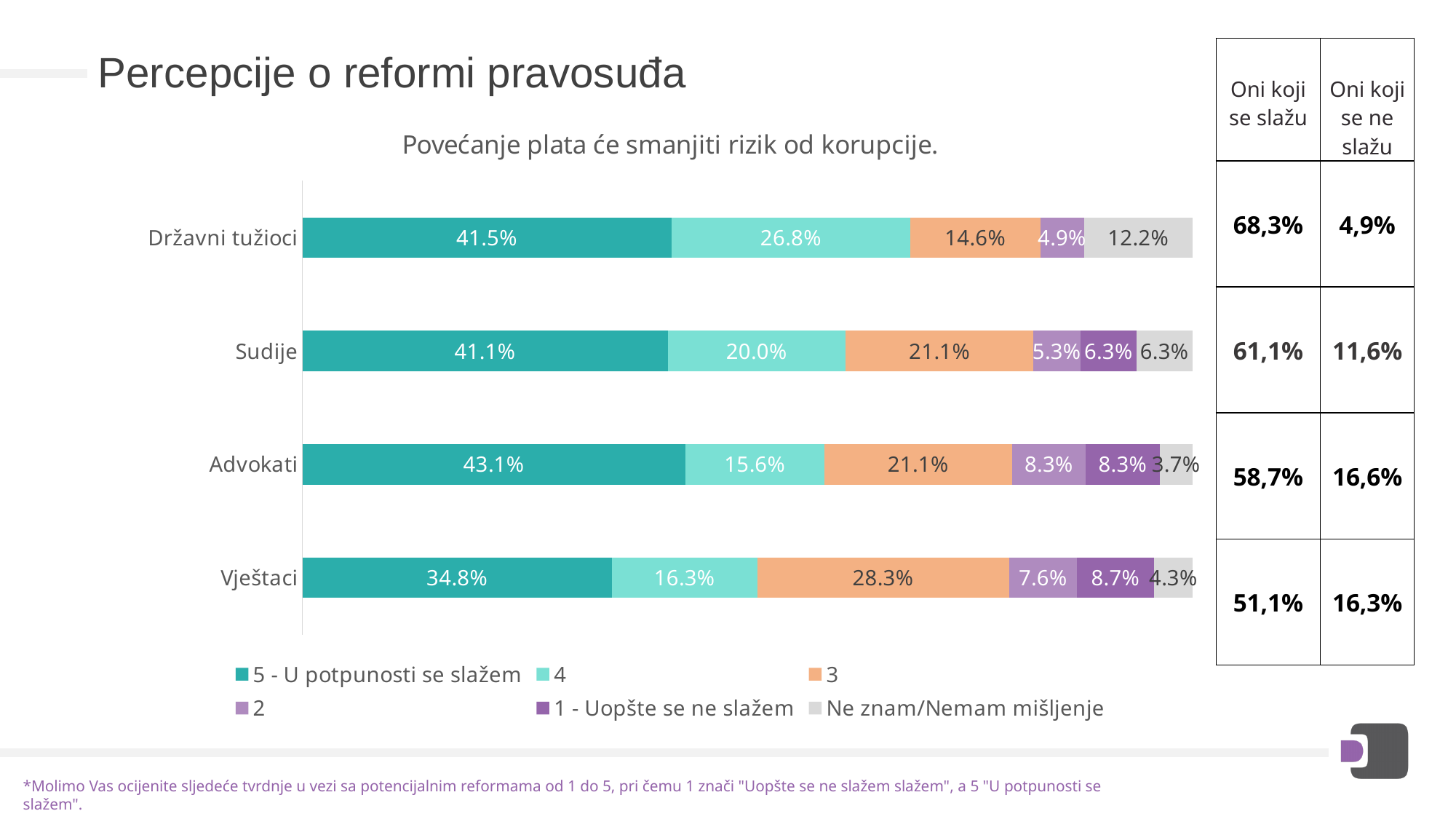
How many series does the chart legend list? 6 Which group has the lowest "Ne znam/Nemam mišljenje" share? Advokati Which group has the highest share of "5 - U potpunosti se slažem"? Advokati What is the difference between the "1 - Uopšte se ne slažem" shares of Vještaci and Sudije? 2.4 percentage points What type of chart is shown on the slide? Stacked bar chart What is the value of the "2" segment for Advokati? 8.3% What percentage of Sudije answered "3" in the chart "Povećanje plata će smanjiti rizik od korupcije."? 21.1% What share of Vještaci chose "5 - U potpunosti se slažem"? 34.8% How many groups (categories) are shown in the chart? 4 How many percentage points higher is the "4" share for Državni tužioci than for Advokati? 11.2 percentage points What is the "Ne znam/Nemam mišljenje" value for Državni tužioci? 12.2% Which group has a larger "3" share, Vještaci or Sudije? Vještaci